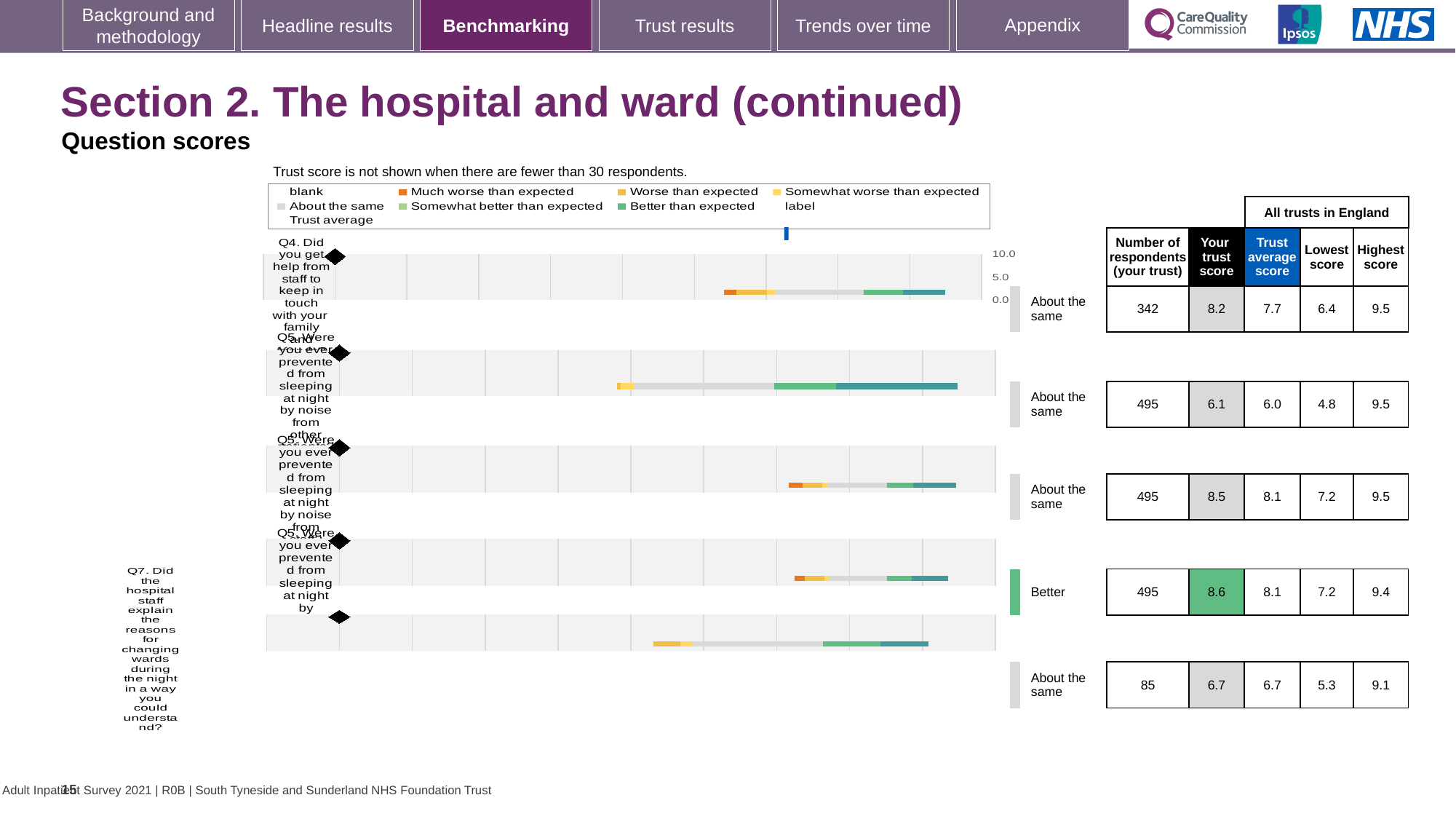
Which row has the highest 'Your trust score' in the table? the fourth row (rated Better), 8.6 What is the 'Your trust score' for Q4 (help from staff to keep in touch with family and friends)? 8.2 What is the 'Your trust score' for the last row, Q7 (explaining reasons for changing wards during the night)? 6.7 How many of the five rows are rated 'About the same'? 4 What is the difference between the highest score and the lowest score for Q7 (the last row)? 3.8 How many respondents answered Q4 at this trust? 342 According to the note above the chart, below how many respondents is the trust score not shown? 30 Which is larger for Q4: the trust's own score or the trust average score? the trust's own score What is the difference between the trust score and the trust average score for Q4? 0.5 What is the trust average score for Q4 (help from staff to keep in touch with family and friends)? 7.7 What kind of chart is used to show the question scores on this slide? bar chart How many question rows (bars) are plotted in the chart? 5